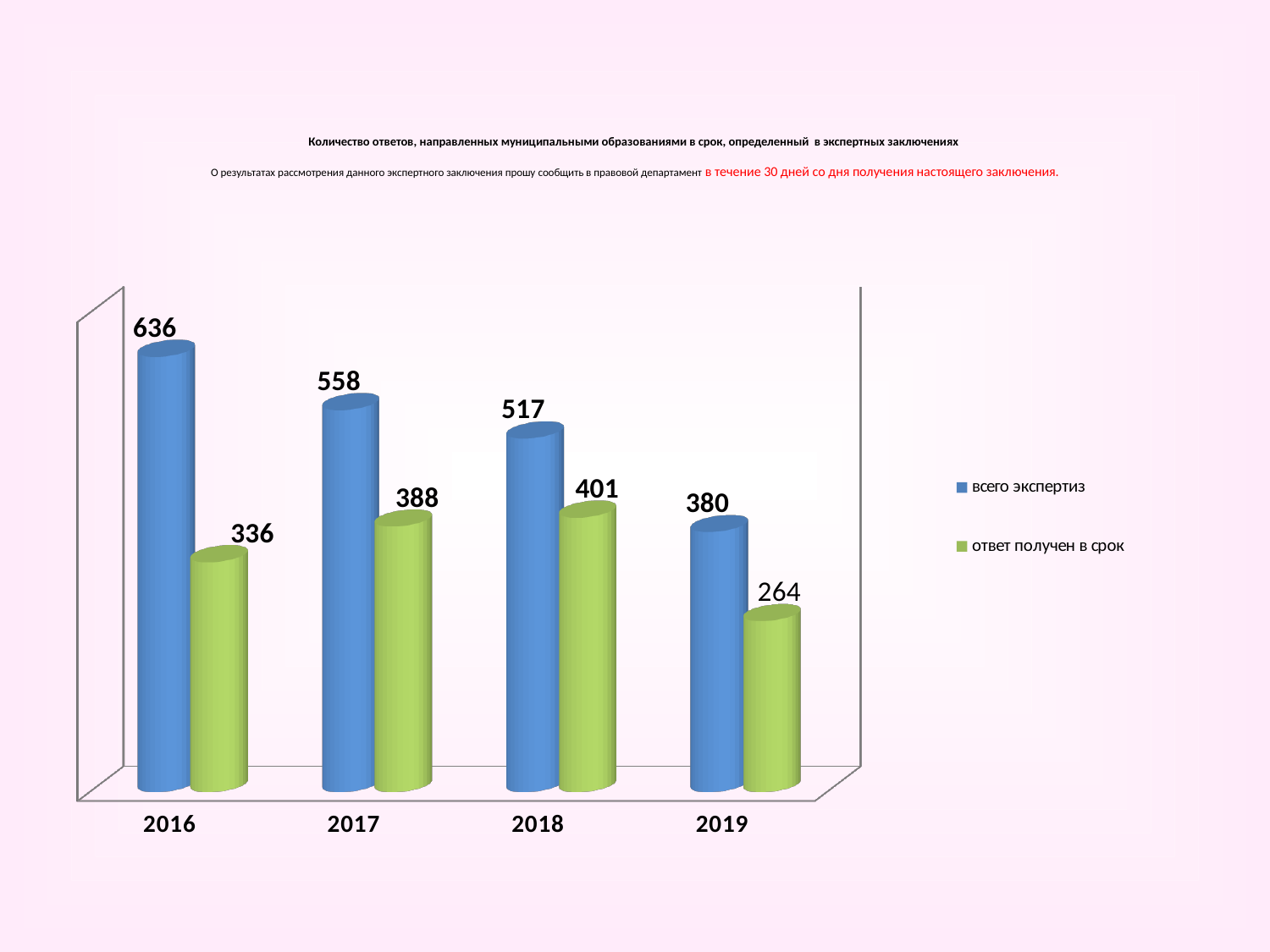
What is the value of "ответ получен в срок" for 2019? 264 What is the difference between the "всего экспертиз" values for 2016 and 2019? 256 Which year has the highest value for "всего экспертиз"? 2016 Do the values for "всего экспертиз" rise or fall from 2016 to 2019? fall Which year has the lowest value for "ответ получен в срок"? 2019 What is the difference between "всего экспертиз" and "ответ получен в срок" in 2017? 170 What is the value of "всего экспертиз" for 2016? 636 How many years are shown on the x axis? 4 How many series does the legend list? 2 Which is larger: "ответ получен в срок" in 2017 or in 2018? 2018 What is the value of "ответ получен в срок" for 2018? 401 What kind of chart is shown on the slide? bar chart